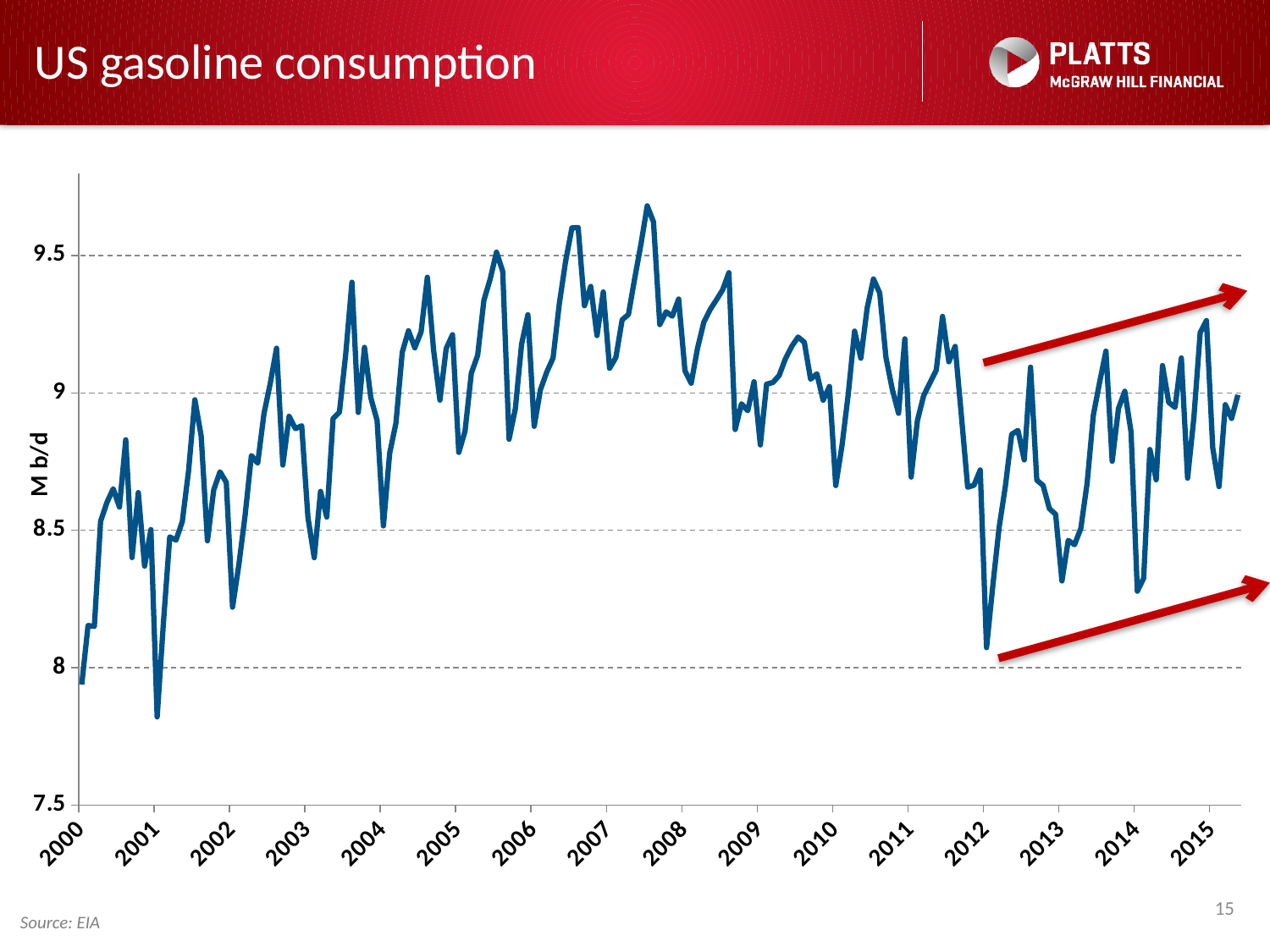
Is the lowest value reached in 2001 greater or less than 8? less How many year labels are shown on the horizontal axis? 16 Is the peak value reached in 2007 greater or less than 9.5? greater Is the low point reached at the start of 2014 greater or less than 8.5? less What is the label on the vertical axis? M b/d In which year does the line reach its lowest value? 2001 What is the title of the chart? US gasoline consumption Which is larger: the peak value in 2007 or the peak value in 2013? 2007 What kind of chart is shown on the slide? line chart In which year does the line reach its highest value? 2007 Does the line generally rise or fall between 2000 and 2007? rise